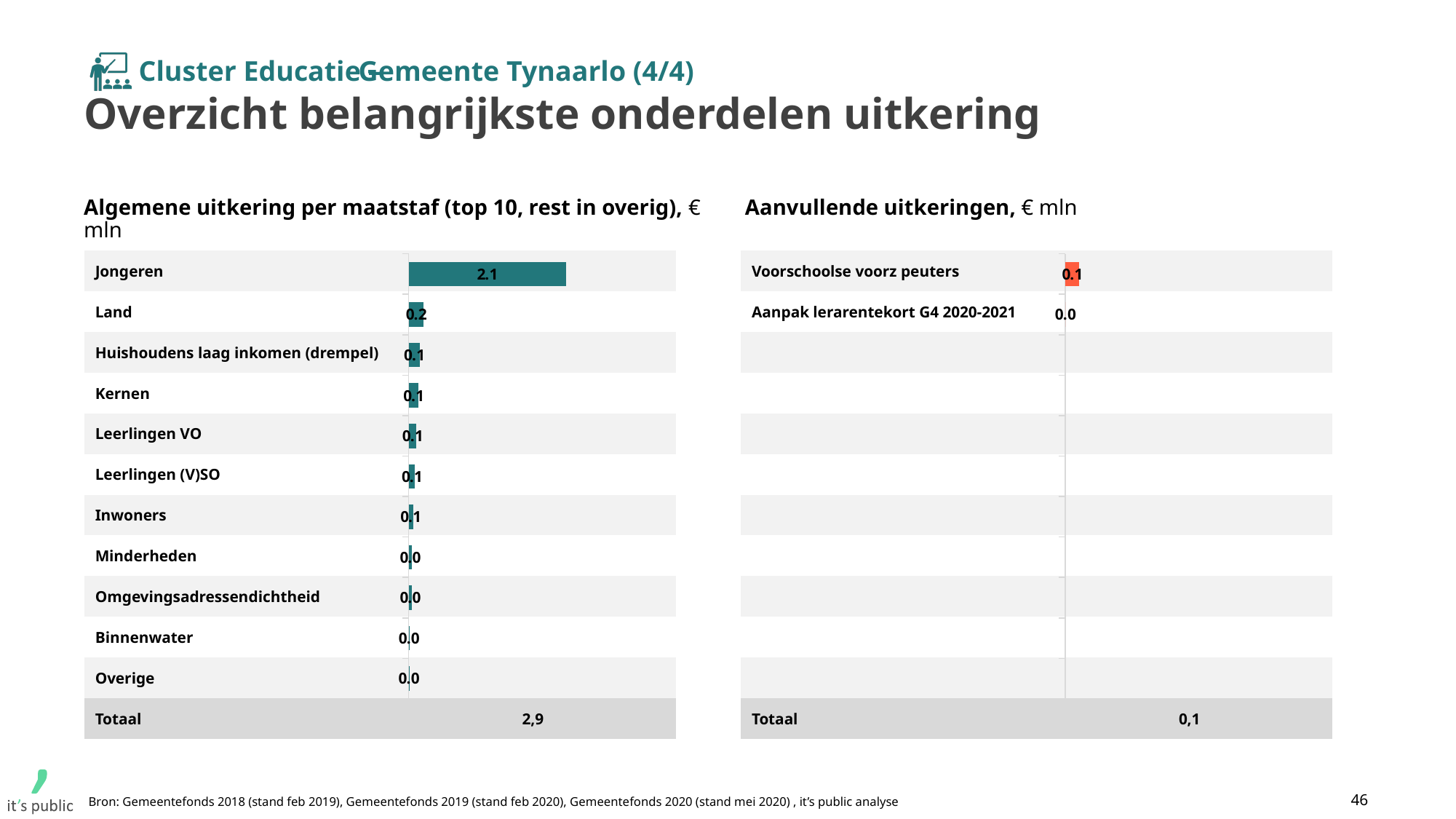
What is the Totaal shown for the chart 'Aanvullende uitkeringen'? 0,1 What kind of chart is the chart 'Aanvullende uitkeringen'? Bar chart In the chart 'Algemene uitkering per maatstaf', what is the value for Huishoudens laag inkomen (drempel)? 0.1 How many categories are shown in the chart 'Algemene uitkering per maatstaf' (excluding the Totaal row)? 11 In the chart 'Algemene uitkering per maatstaf', what is the value for Land? 0.2 In the chart 'Algemene uitkering per maatstaf', what is the value for Jongeren? 2.1 In the chart 'Algemene uitkering per maatstaf', which category has the highest value? Jongeren In the chart 'Aanvullende uitkeringen', what is the value for Voorschoolse voorz peuters? 0.1 In the chart 'Algemene uitkering per maatstaf', what is the difference between the values for Jongeren and Land? 1.9 In the chart 'Aanvullende uitkeringen', what is the value for Aanpak lerarentekort G4 2020-2021? 0.0 In the chart 'Algemene uitkering per maatstaf', which is larger, the value for Jongeren or the value for Land? Jongeren What is the Totaal shown for the chart 'Algemene uitkering per maatstaf'? 2,9